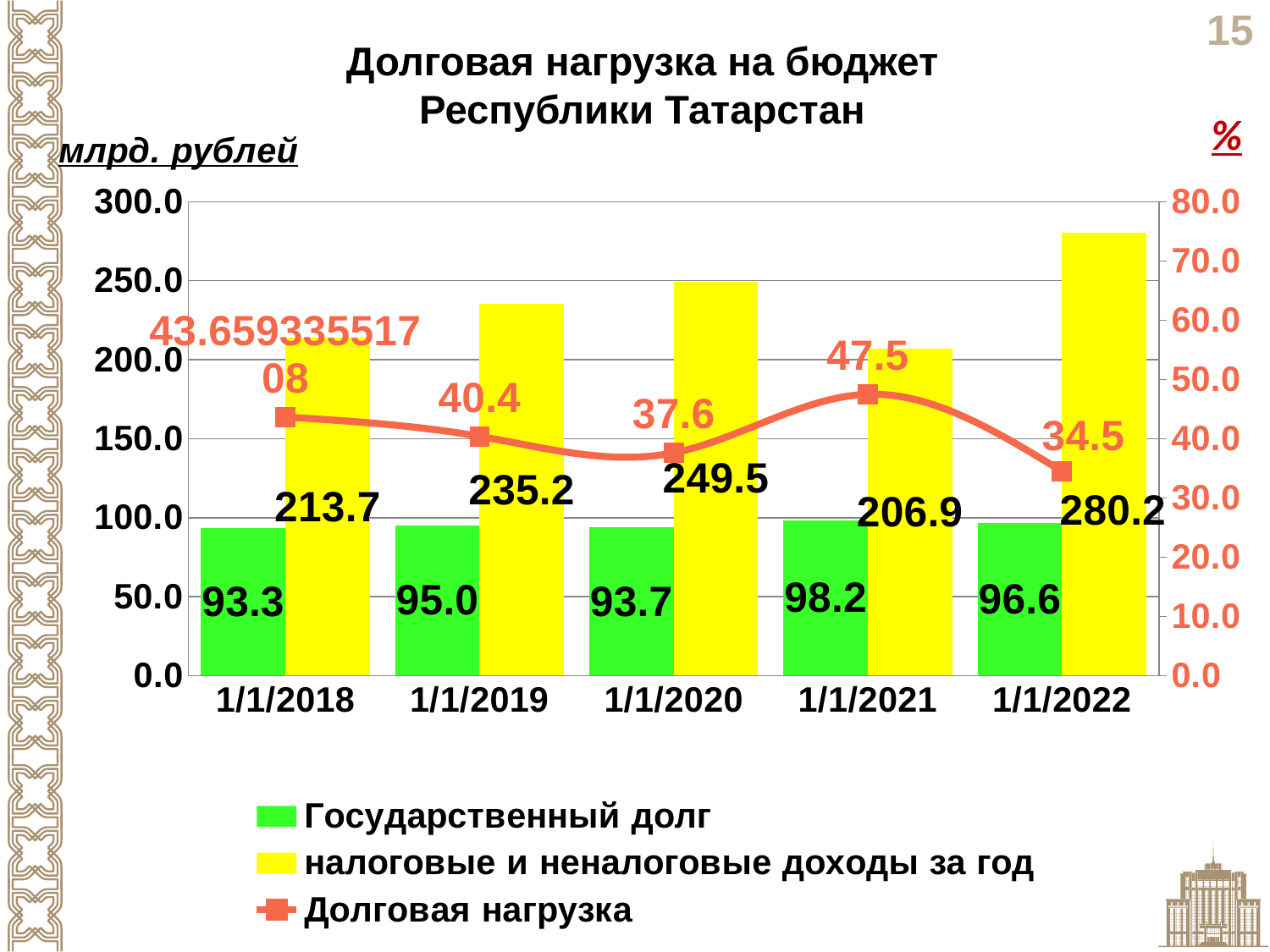
In which year is Долговая нагрузка the lowest? 1/1/2022 Which is larger: Государственный долг for 1/1/2019 or for 1/1/2022? 1/1/2022 In which year is Государственный долг the highest? 1/1/2021 Does Долговая нагрузка rise or fall from 1/1/2021 to 1/1/2022? fall What is the value of Государственный долг for 1/1/2021? 98.2 What is the difference between налоговые и неналоговые доходы за год for 1/1/2022 and 1/1/2021? 73.3 How many series does the legend list? 3 What colour are the bars for Государственный долг? green What is the Долговая нагрузка value for 1/1/2020? 37.6 How many dates are shown on the x axis? 5 What is the value of налоговые и неналоговые доходы за год for 1/1/2022? 280.2 In which year is налоговые и неналоговые доходы за год the highest? 1/1/2022